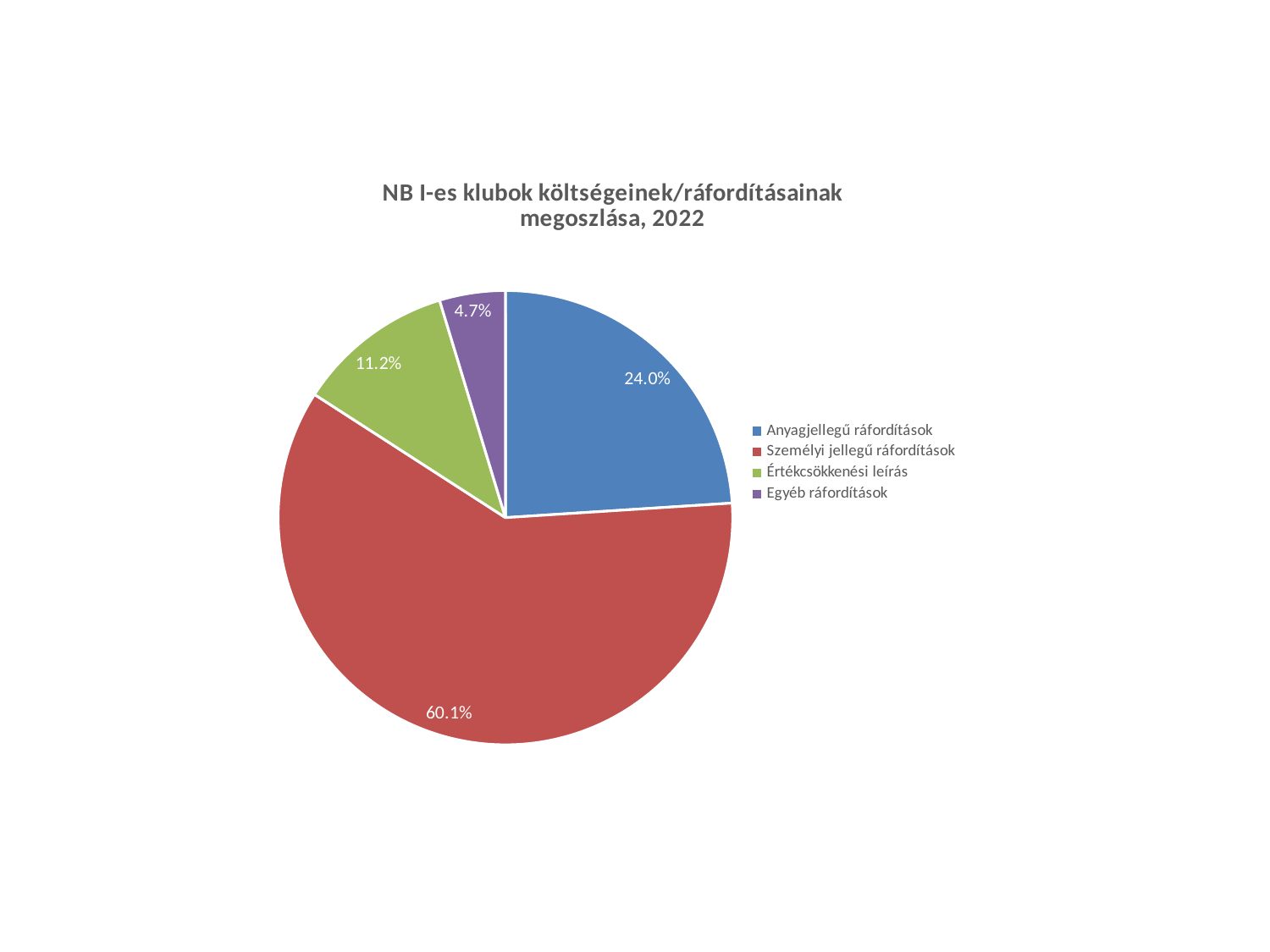
What is the value shown for Anyagjellegű ráfordítások? 24.0% What is the value shown for Egyéb ráfordítások? 4.7% What is the value shown for Értékcsökkenési leírás? 11.2% What is the difference between the shares of Személyi jellegű ráfordítások and Anyagjellegű ráfordítások? 36.1% Which is larger, the share of Anyagjellegű ráfordítások or the share of Értékcsökkenési leírás? Anyagjellegű ráfordítások What kind of chart is shown on the slide? pie chart Which category has the largest slice of the pie? Személyi jellegű ráfordítások What is the title of the chart? NB I-es klubok költségeinek/ráfordításainak megoszlása, 2022 What share of the pie does Személyi jellegű ráfordítások have? 60.1% How many categories does the pie chart have? 4 Which category has the smallest slice of the pie? Egyéb ráfordítások What is the difference between the shares of Értékcsökkenési leírás and Egyéb ráfordítások? 6.5%